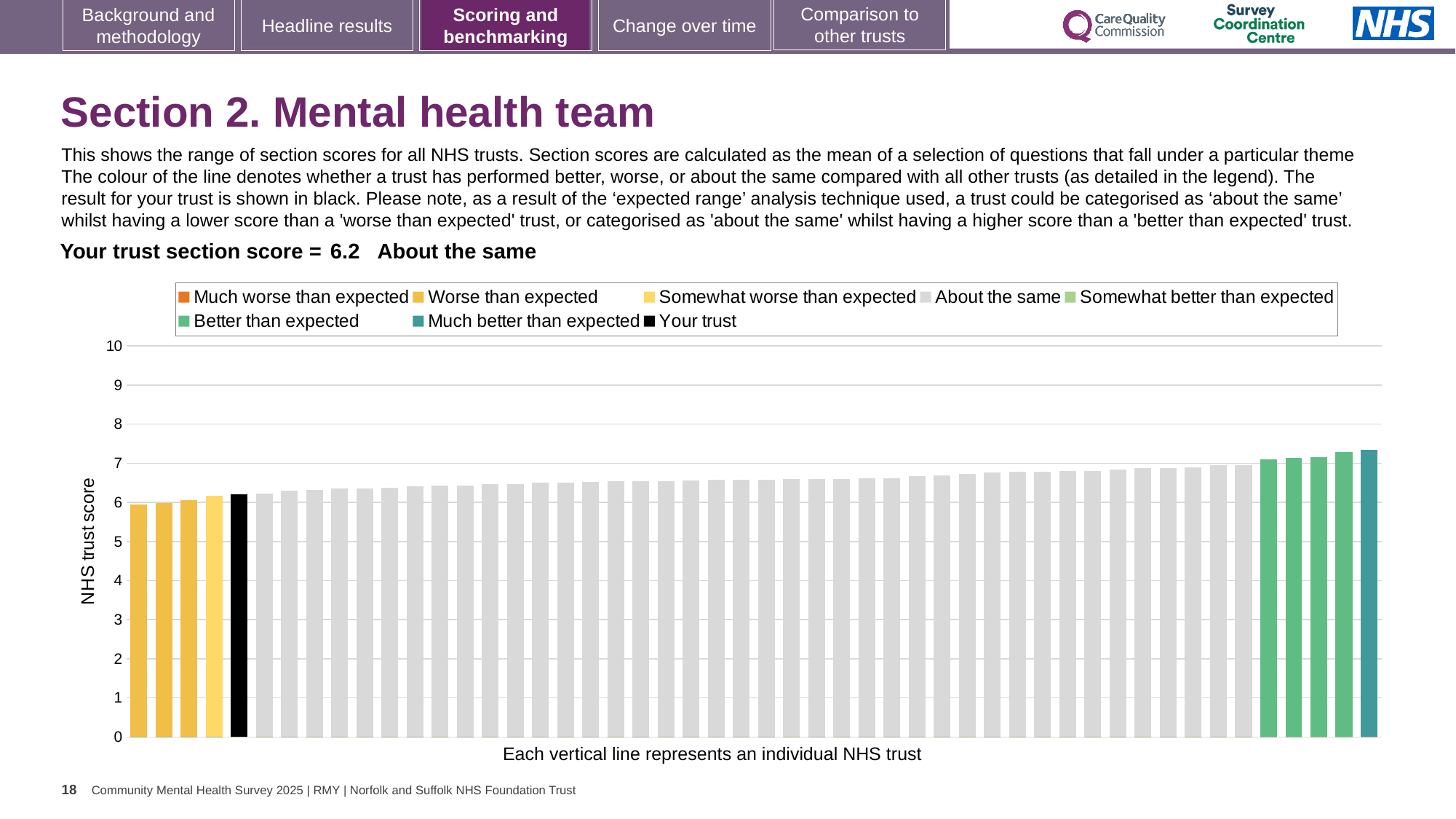
Is the value of the tallest bar (rightmost) greater or less than 7? greater How many bars are coloured black in the chart? 1 Do the bar values rise or fall from left to right across the chart? Rise What kind of chart is shown on the slide? Bar chart Is the value of the black 'Your trust' bar greater or less than 5? greater Is the value of the shortest bar (leftmost) greater or less than 5? greater What is the label on the vertical axis of the chart? NHS trust score According to the slide, which category does your trust's section score fall into? About the same How many entries does the chart legend list? 8 What is the section score for your trust, as printed on the slide? 6.2 Which bar is taller: the leftmost bar or the rightmost bar? The rightmost bar